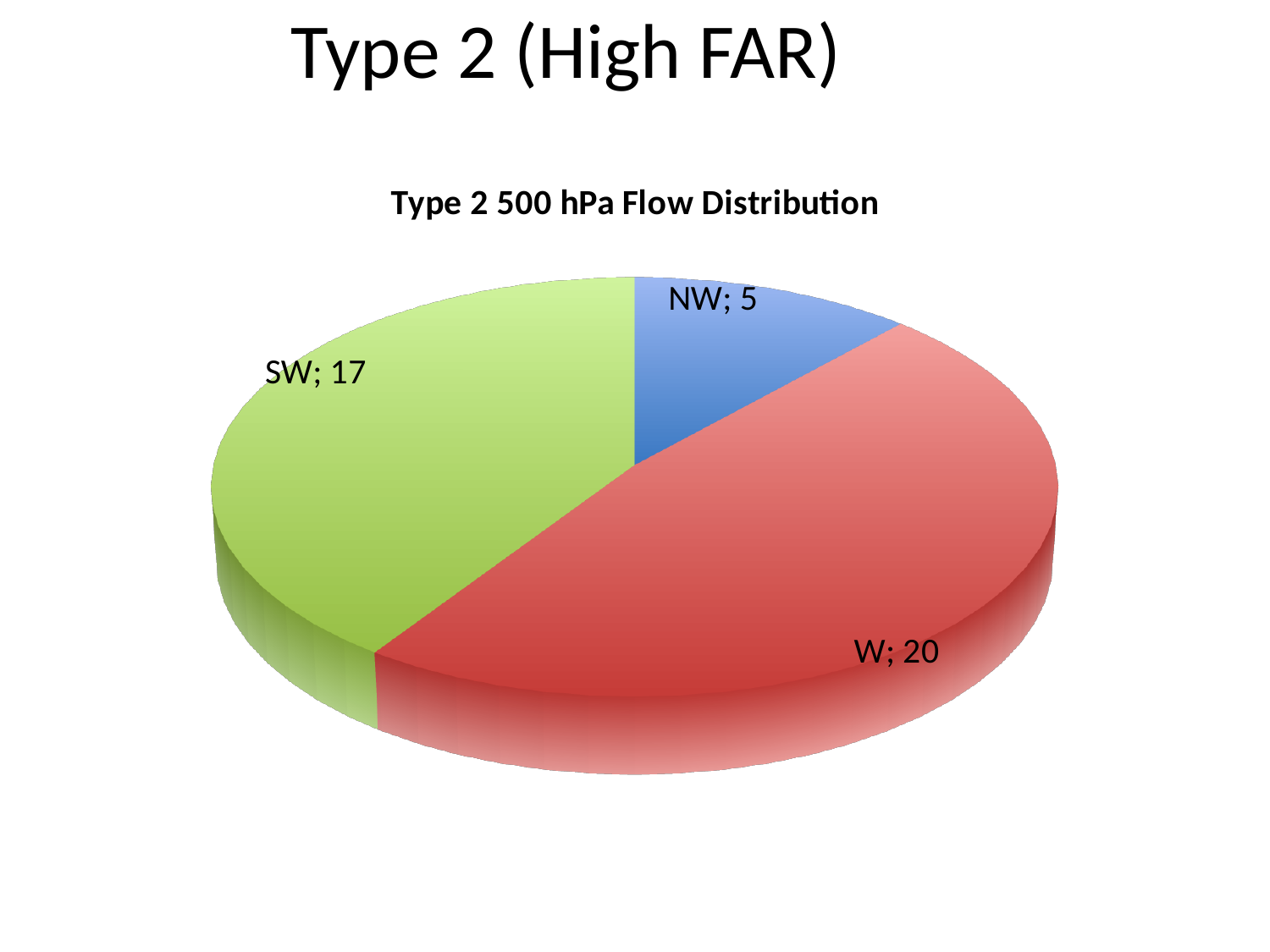
Which is larger, the value for SW or the value for NW? SW What is the difference between the values for SW and NW? 12 How many categories are shown in the pie chart? 3 What is the value for W in the pie chart? 20 Which category has the largest slice in the pie chart? W What is the value for SW in the pie chart? 17 What is the total of all slices in the pie chart? 42 Which category has the smallest slice in the pie chart? NW What is the difference between the values for W and SW? 3 What is the value for NW in the pie chart? 5 What is the title of the chart? Type 2 500 hPa Flow Distribution What kind of chart is shown on the slide? Pie chart